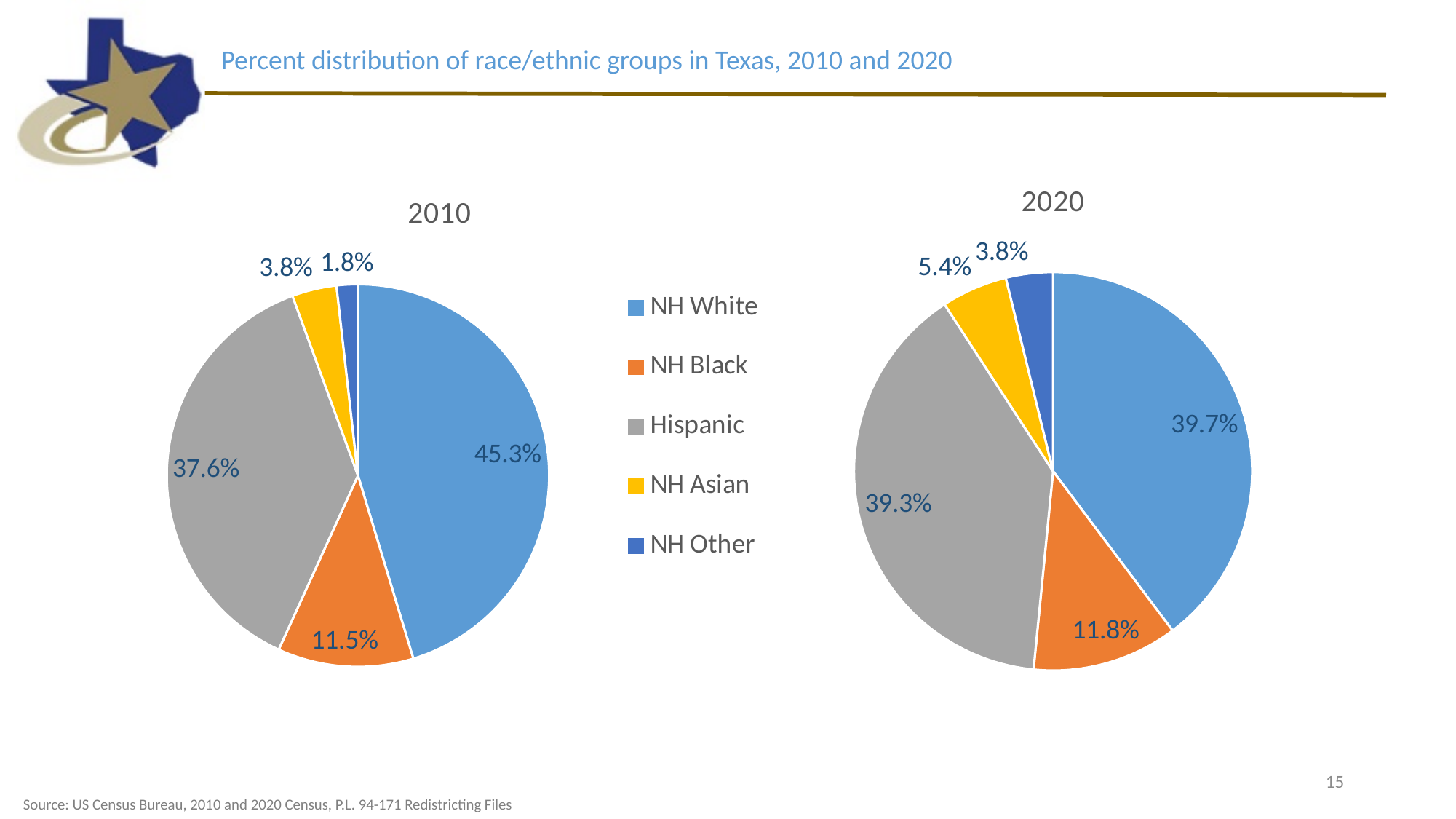
In the 2010 pie chart, which group has the smallest share? NH Other In the 2020 pie chart, what is the share for NH Asian? 5.4% In the 2020 pie chart, is the share for NH White or Hispanic larger? NH White In the 2020 pie chart, what is the share for Hispanic? 39.3% What type of chart is used on this slide? Pie chart In the 2010 pie chart, what is the share for NH White? 45.3% How many groups does the legend list? 5 In the 2010 pie chart, which group has the largest share? NH White Which colour represents Hispanic in the pie charts? Grey In the 2010 pie chart, what is the share for NH Other? 1.8% In the 2020 pie chart, which group has the smallest share? NH Other What is the difference between the NH White share in 2010 and in 2020? 5.6%